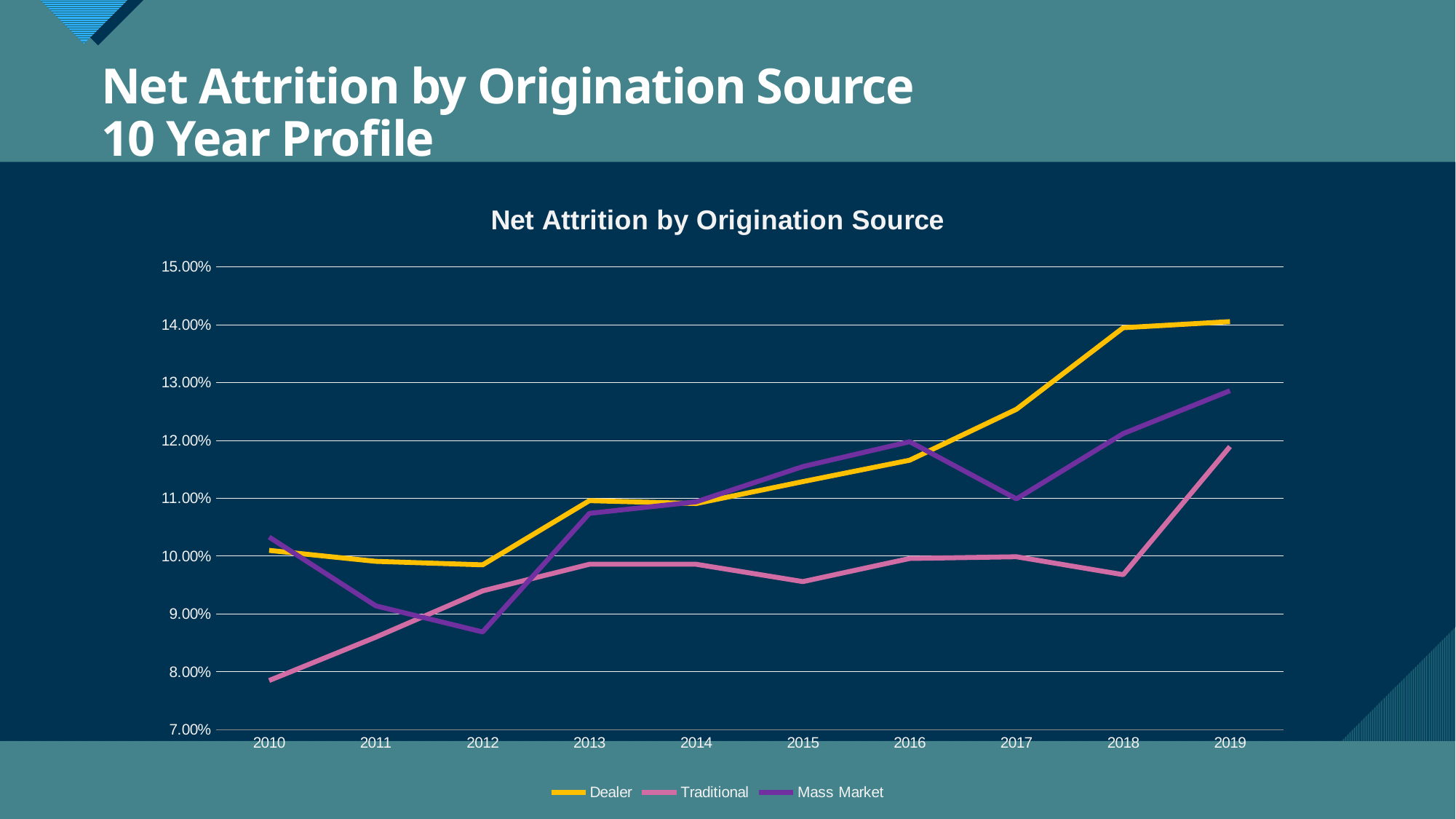
Is the value for Traditional in 2019 greater or less than 11.00%? greater Does the Dealer series rise or fall from 2012 to 2019? Rise Which series has the highest value in 2019? Dealer Is the value for Traditional in 2010 greater or less than 8.00%? less In which year is the Mass Market series at its lowest? 2012 Which series has the lowest value in 2010? Traditional What kind of chart is shown on the slide? Line chart Is the value for Mass Market in 2012 greater or less than 9.00%? less In 2017, which is larger: Mass Market or Traditional? Mass Market How many series does the legend list? 3 How many years are plotted along the x axis? 10